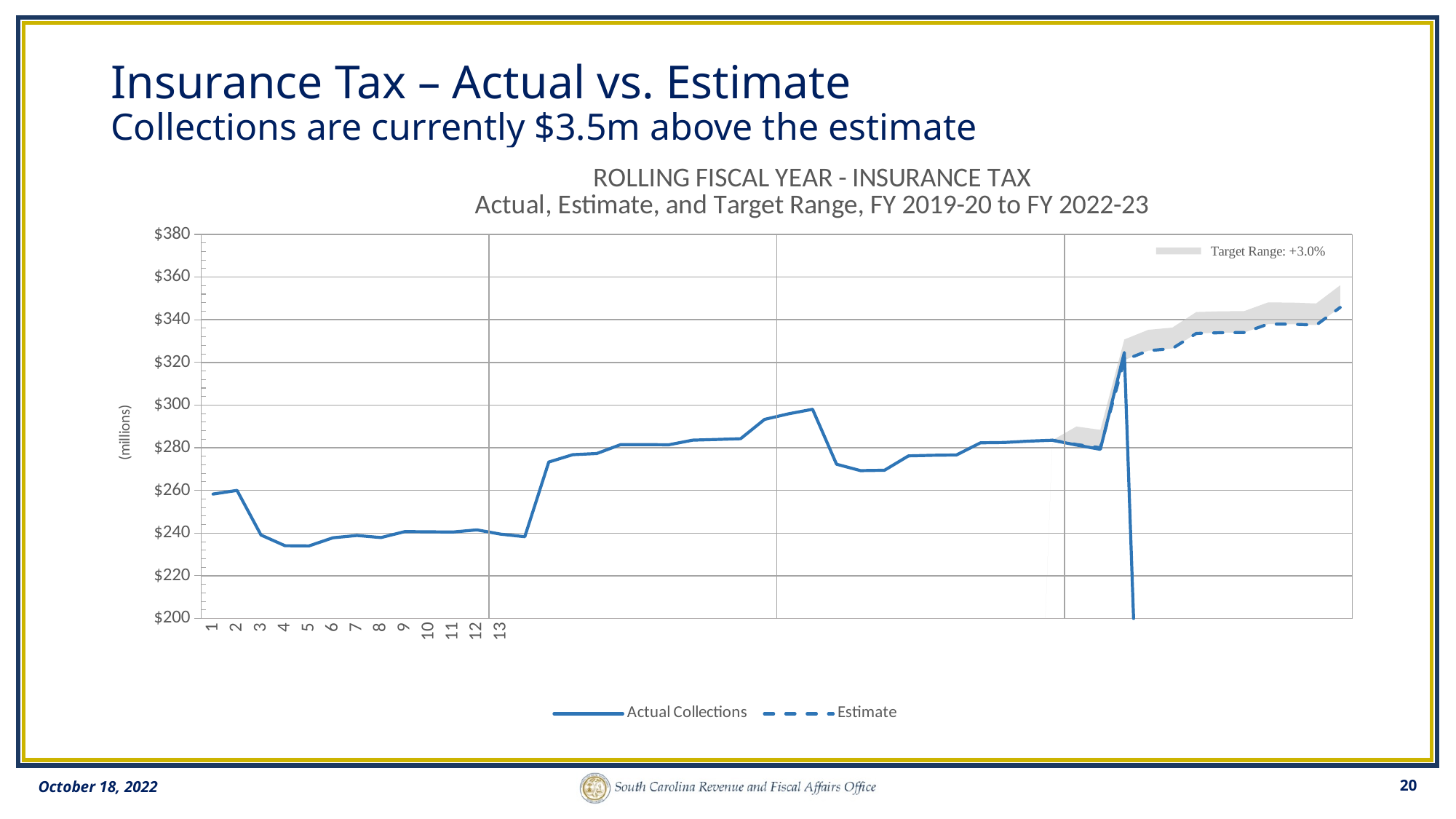
What kind of chart is shown on the slide? line chart What percentage is given for the Target Range in the chart's inset legend? +3.0% What is the highest value shown on the y axis? $380 How many series does the legend below the chart list? 2 Do the Actual Collections values rise or fall from point 2 to point 4? fall Is the Actual Collections value at point 13 greater or less than $260? less Is the Actual Collections value at point 1 greater or less than $240? greater Is the Actual Collections value at point 4 greater or less than $240? less What are the two series named in the legend below the chart? Actual Collections and Estimate Which is larger, the Actual Collections value at point 1 or at point 4? point 1